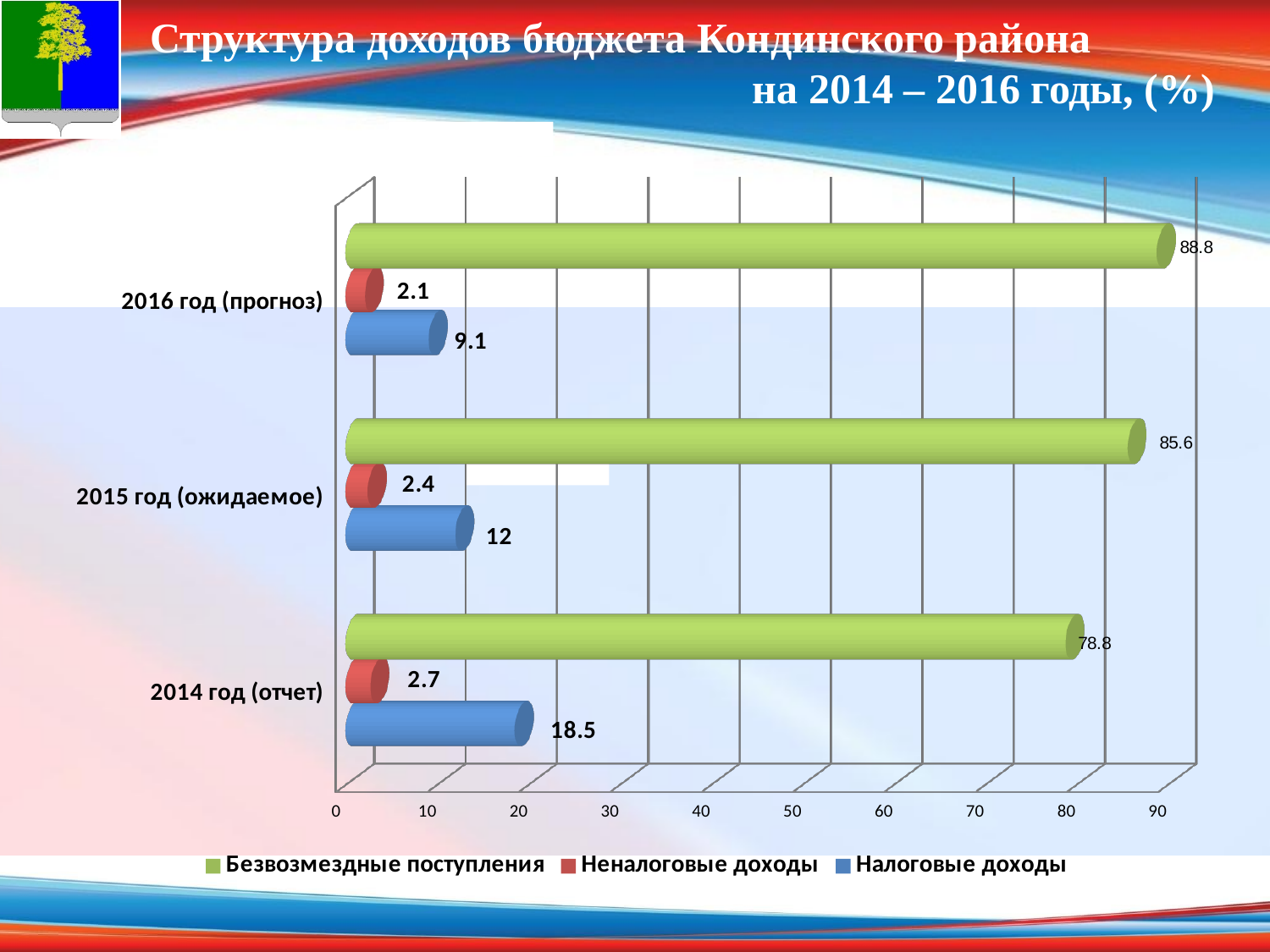
Which colour represents Неналоговые доходы in the chart? Red How many series does the legend list? 3 How many year categories are shown on the chart? 3 What is the difference between Налоговые доходы in 2014 год (отчет) and 2016 год (прогноз)? 9.4 What is the value of Налоговые доходы for 2014 год (отчет)? 18.5 Which year has the highest value for Безвозмездные поступления? 2016 год (прогноз) What kind of chart is shown on the slide? Bar chart Which is larger: Безвозмездные поступления in 2015 год (ожидаемое) or in 2014 год (отчет)? 2015 год (ожидаемое) What is the value of Неналоговые доходы for 2015 год (ожидаемое)? 2.4 Which year has the lowest value for Налоговые доходы? 2016 год (прогноз) What is the value of Безвозмездные поступления for 2016 год (прогноз)? 88.8 What is the value of Налоговые доходы for 2015 год (ожидаемое)? 12